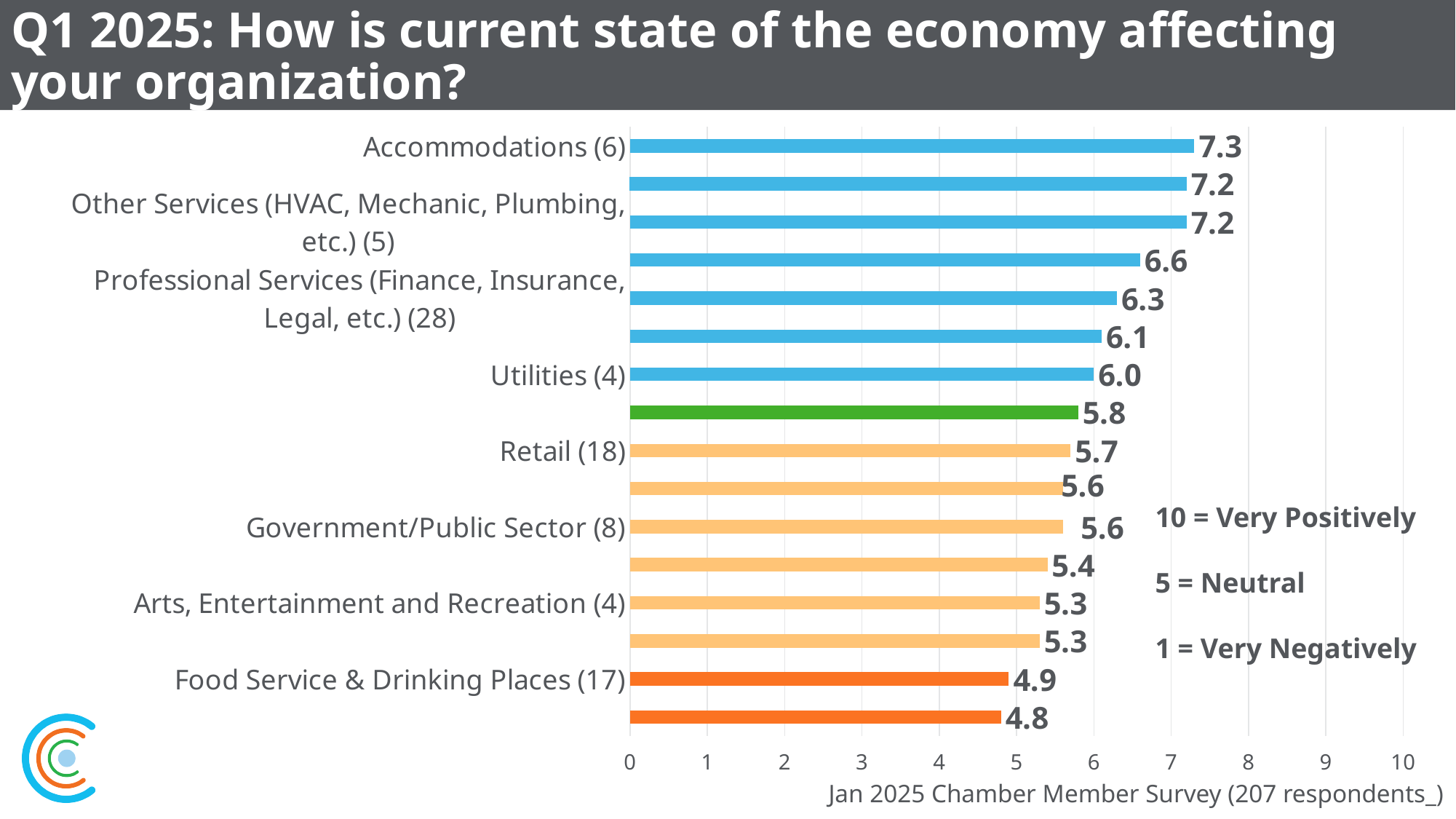
Is the value for Arts, Entertainment and Recreation (4) greater or less than 6? less Which is larger, the value for Utilities (4) or the value for Retail (18)? Utilities (4) What kind of chart is shown on the slide? bar chart What is the lowest value shown on the chart? 4.8 What is the value for Retail (18)? 5.7 Which labeled category has the highest value? Accommodations (6) What is the difference between the values for Accommodations (6) and Food Service & Drinking Places (17)? 2.4 What is the value for Accommodations (6)? 7.3 How many bars are plotted on the chart? 16 What is the value for Utilities (4)? 6.0 What is the value for Government/Public Sector (8)? 5.6 What is the value for Food Service & Drinking Places (17)? 4.9